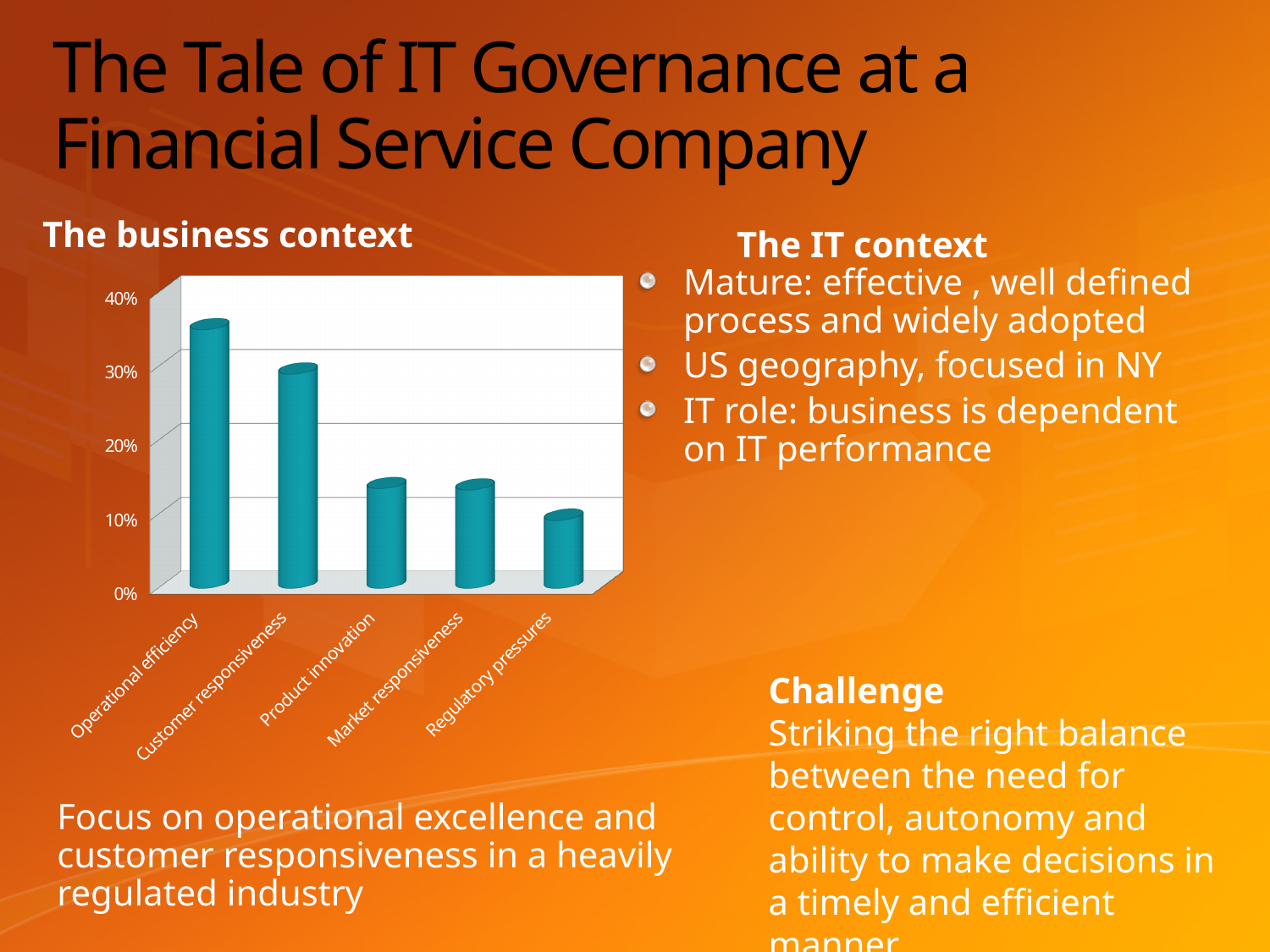
Is the value for Operational efficiency greater or less than 40%? less How many categories are plotted in the bar chart? 5 What is the heading shown above the bar chart? The business context Is the value for Operational efficiency greater or less than 30%? greater Do the bar values generally rise or fall from left to right across the categories? fall Which is larger, the value for Customer responsiveness or the value for Regulatory pressures? Customer responsiveness Is the value for Product innovation greater or less than 20%? less Which category has the lowest bar in the chart? Regulatory pressures Which category has the highest bar in the chart? Operational efficiency What kind of chart is shown under "The business context"? bar chart